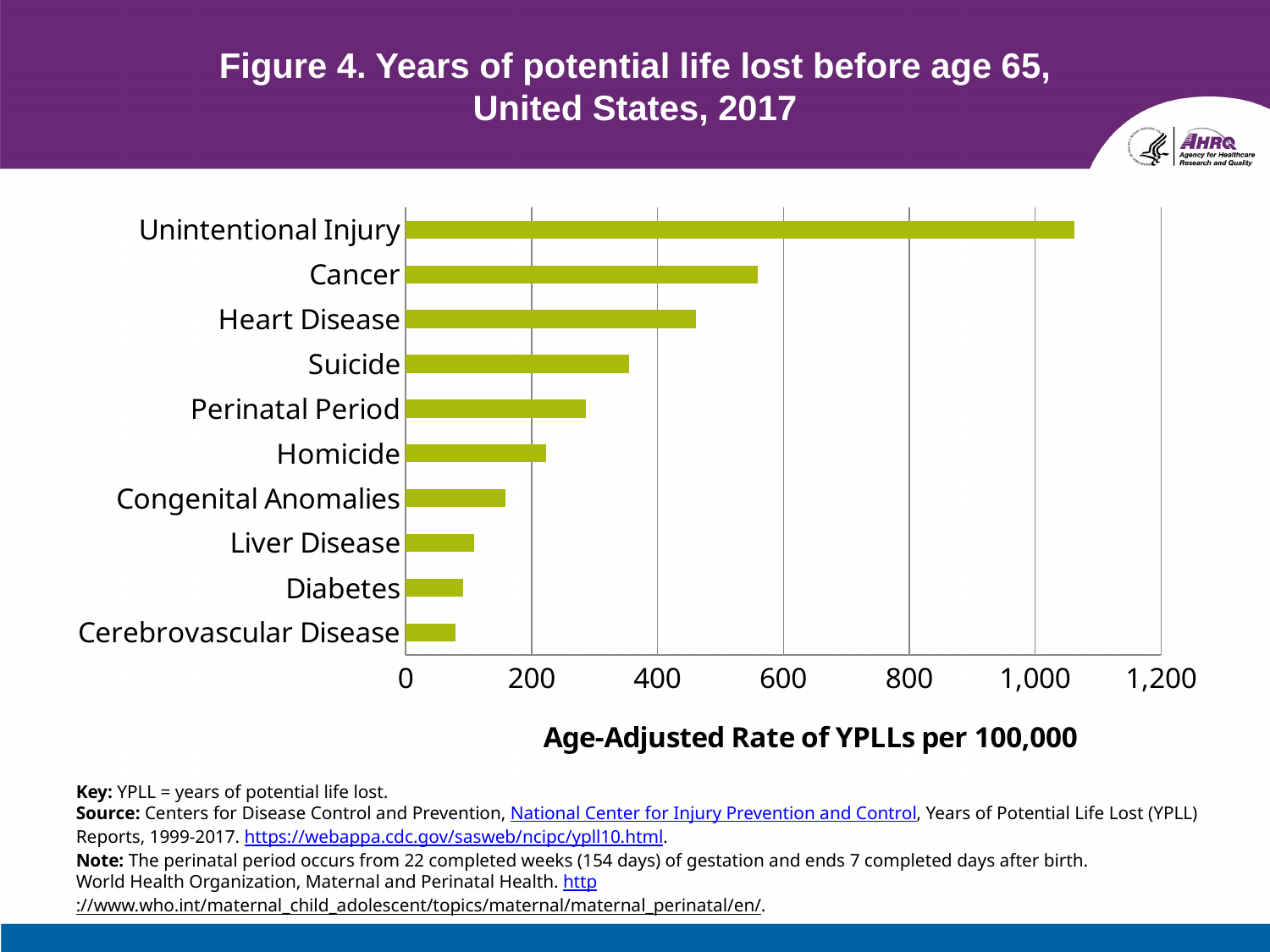
Is the value for Cancer greater or less than 600? less Is the value for Suicide greater or less than 400? less What kind of chart is shown on the slide? bar chart What is the title of the horizontal axis? Age-Adjusted Rate of YPLLs per 100,000 Is the value for Unintentional Injury greater or less than 1,000? greater Which has a higher rate, Cancer or Heart Disease? Cancer How many causes of death are listed on the chart? 10 Which cause has the highest age-adjusted rate of YPLLs per 100,000? Unintentional Injury Which has a higher rate, Suicide or Perinatal Period? Suicide